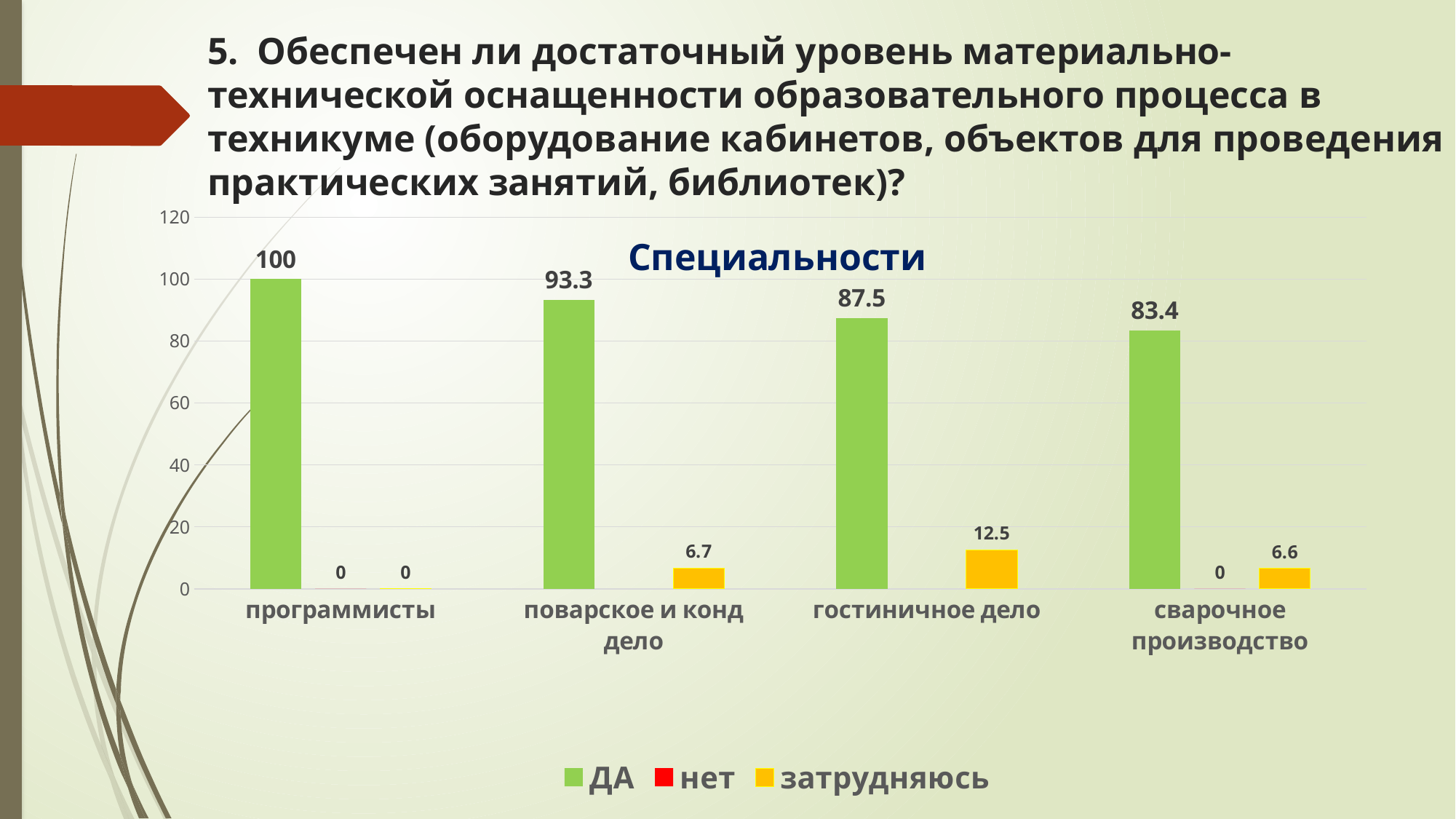
What is the value of the затрудняюсь series for сварочное производство? 6.6 How many categories are shown on the x axis? 4 Is the ДА value for поварское и конд дело greater or less than 80? greater What is the value of the ДА series for программисты? 100 What is the value of the затрудняюсь series for поварское и конд дело? 6.7 Which category has the highest value in the ДА series? программисты Which is larger: the затрудняюсь value for гостиничное дело or for поварское и конд дело? гостиничное дело What type of chart is shown on the slide? bar chart How many series does the legend list? 3 Which category has the lowest value in the ДА series? сварочное производство What is the difference between the ДА values for программисты and сварочное производство? 16.6 What is the value of the ДА series for гостиничное дело? 87.5